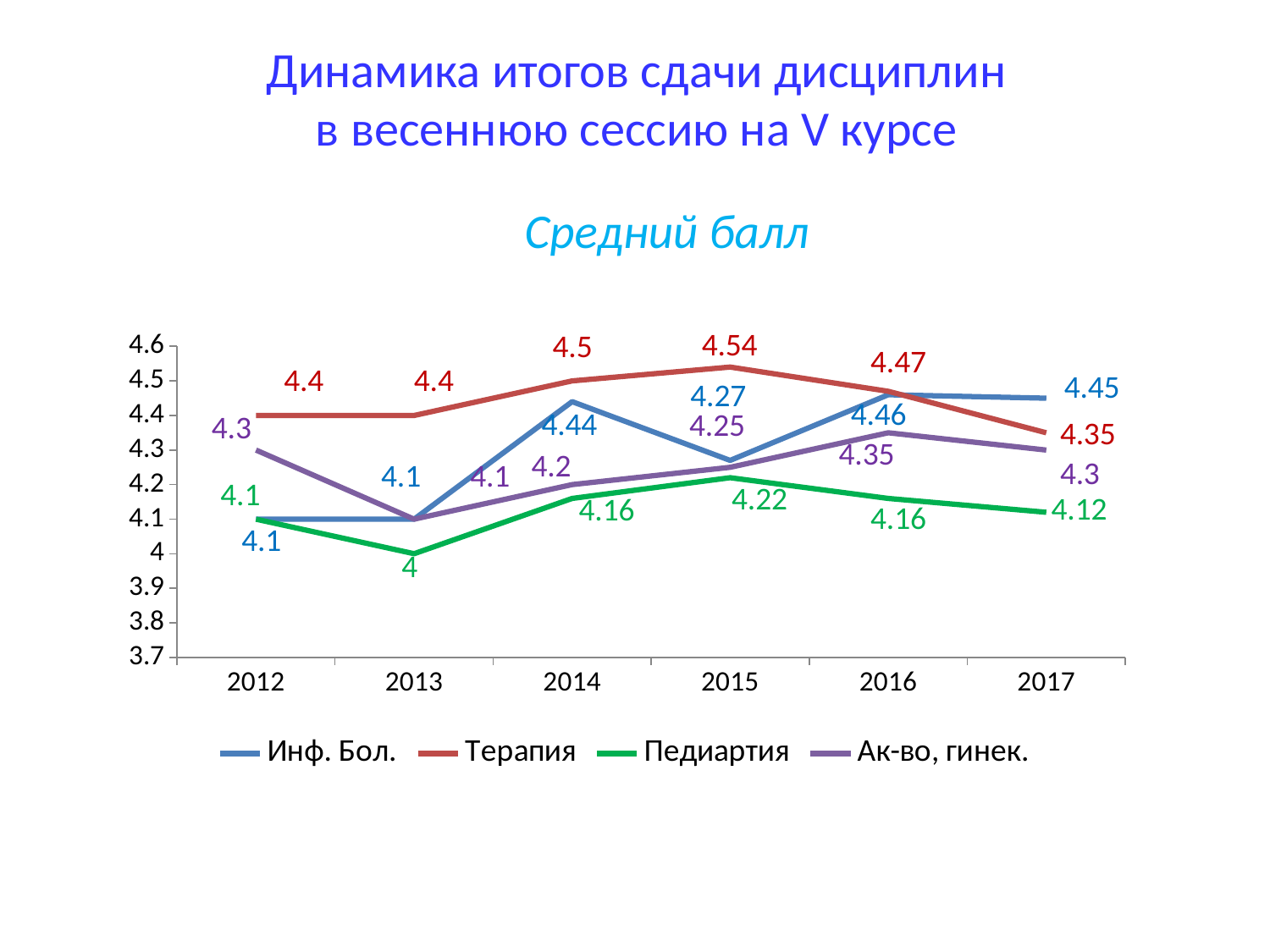
In which year does Терапия reach its highest value? 2015 How many series does the legend list? 4 What is the difference between Терапия and Педиартия in 2017? 0.23 Does the value for Терапия rise or fall from 2015 to 2017? fall What kind of chart is shown on the slide? line chart In which year is the value for Педиартия lowest? 2013 What is the value for Терапия in 2015? 4.54 Which is larger in 2014: Инф. Бол. or Ак-во, гинек.? Инф. Бол. What is the value for Педиартия in 2013? 4 What is the value for Ак-во, гинек. in 2017? 4.3 How many years are shown on the x axis? 6 What is the value for Инф. Бол. in 2016? 4.46